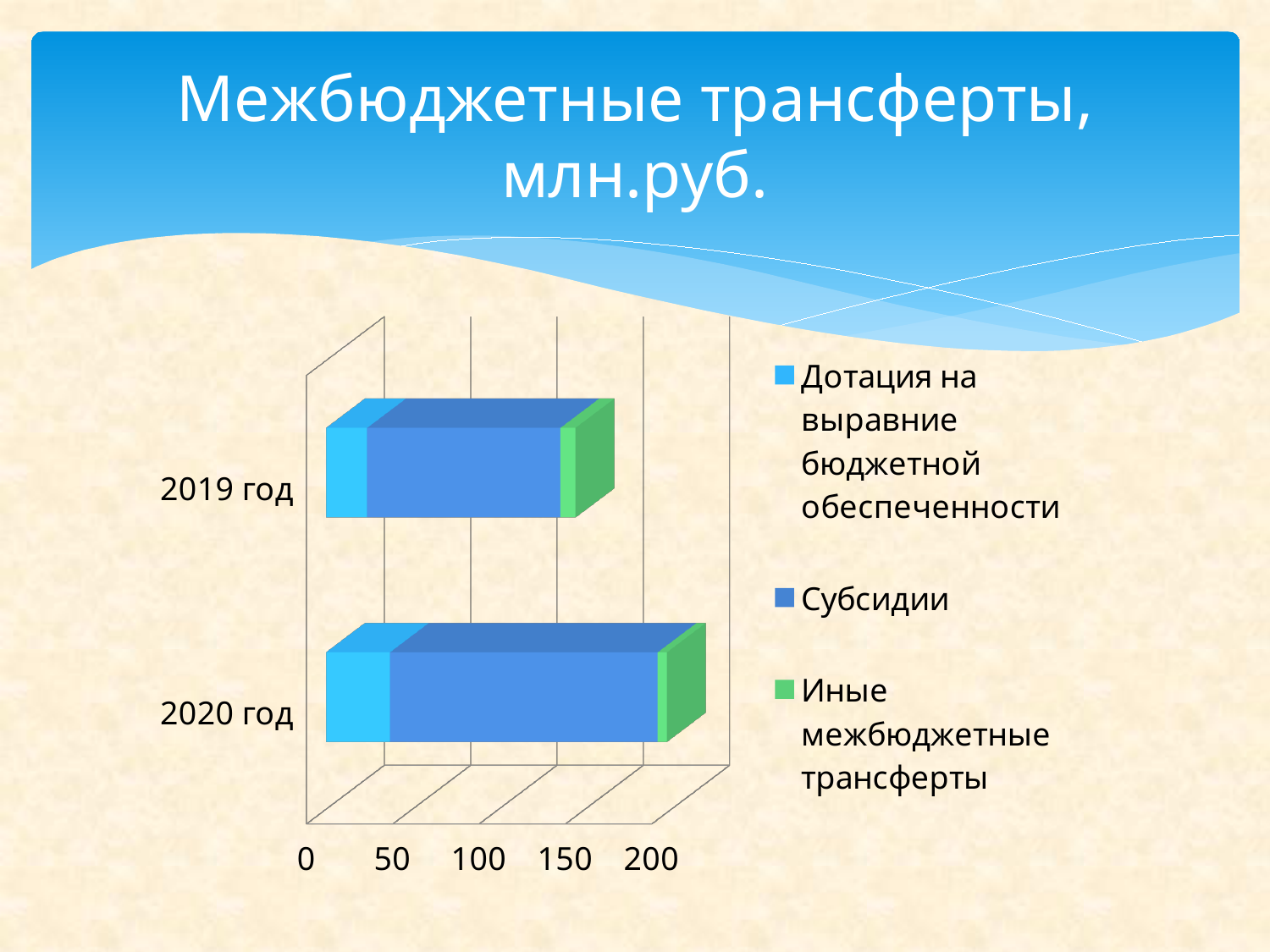
Which year has the longer total bar, 2019 год or 2020 год? 2020 год Is the total value for 2019 год greater or less than 100? greater Is the total value for 2020 год greater or less than 150? greater How many categories (years) are shown on the chart? 2 Which series is shown in green in the legend? Иные межбюджетные трансферты Which series occupies the largest portion of the 2019 год bar? Субсидии Is the total value for 2019 год greater or less than 200? less Does the total bar length rise or fall from 2019 год to 2020 год? rise What is the title of the chart on the slide? Межбюджетные трансферты, млн.руб. What kind of chart is shown on the slide? bar chart How many series does the legend list? 3 Which series occupies the largest portion of the 2020 год bar? Субсидии